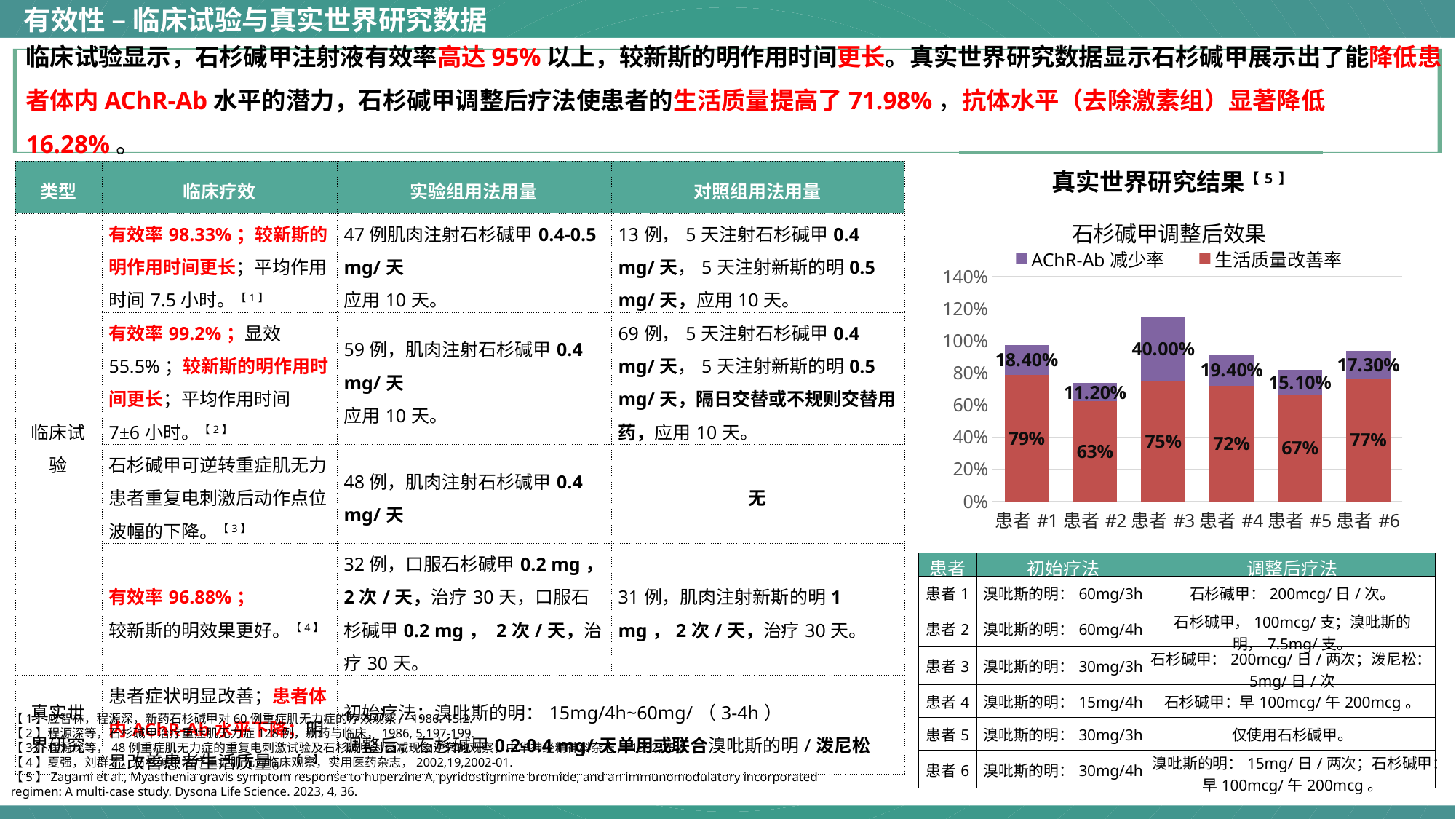
How many series does the chart legend list? 2 What kind of chart is shown on the slide? Stacked bar chart What is the AChR-Ab 减少率 value for 患者 #5? 15.10% Which is larger, the AChR-Ab 减少率 for 患者 #4 or for 患者 #6? 患者 #4 What is the title of the chart? 石杉碱甲调整后效果 What is the 生活质量改善率 value for 患者 #1? 79% How many patients are shown on the x axis of the chart? 6 Which patient has the lowest AChR-Ab 减少率? 患者 #2 What is the AChR-Ab 减少率 value for 患者 #3? 40.00% What is the total stacked value for 患者 #3? 115.00% Which patient has the highest 生活质量改善率? 患者 #1 What is the difference between the 生活质量改善率 of 患者 #6 and 患者 #2? 14%